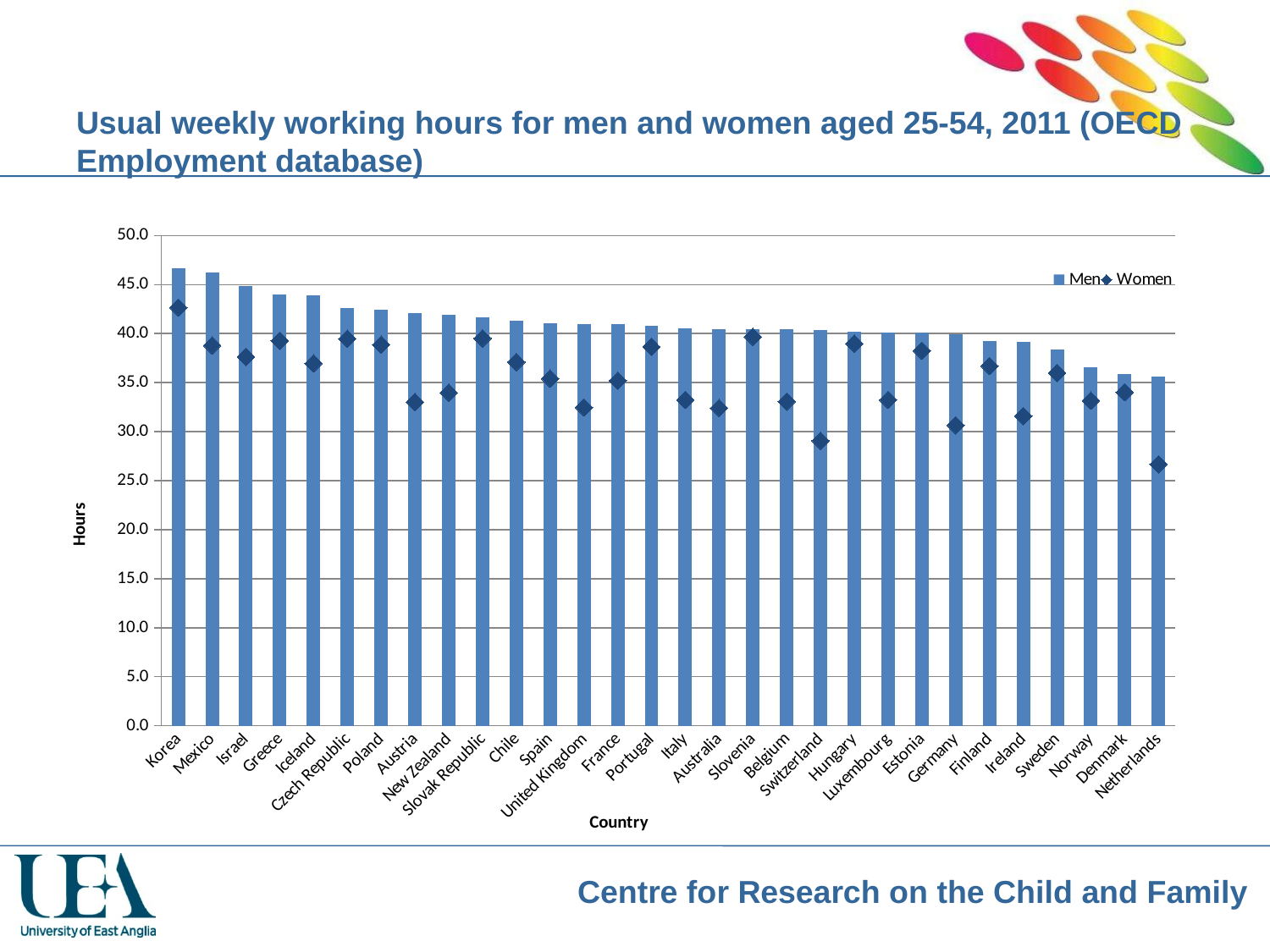
Which country has the lowest usual weekly working hours for men? Netherlands Is the value for women in Austria greater or less than 35.0? less Which is larger, the value for women in Hungary or the value for women in Switzerland? Hungary What kind of chart is shown on the slide? bar chart (with a diamond marker series) Which country has the highest usual weekly working hours for men? Korea How many countries are shown on the x axis? 30 Which country has the highest usual weekly working hours for women? Korea Is the value for women in Switzerland greater or less than 30.0? less Do the values for men rise or fall moving from left to right along the x axis? fall Is the value for men in Korea greater or less than 45.0? greater How many series does the legend list? 2 Which country has the lowest usual weekly working hours for women? Netherlands